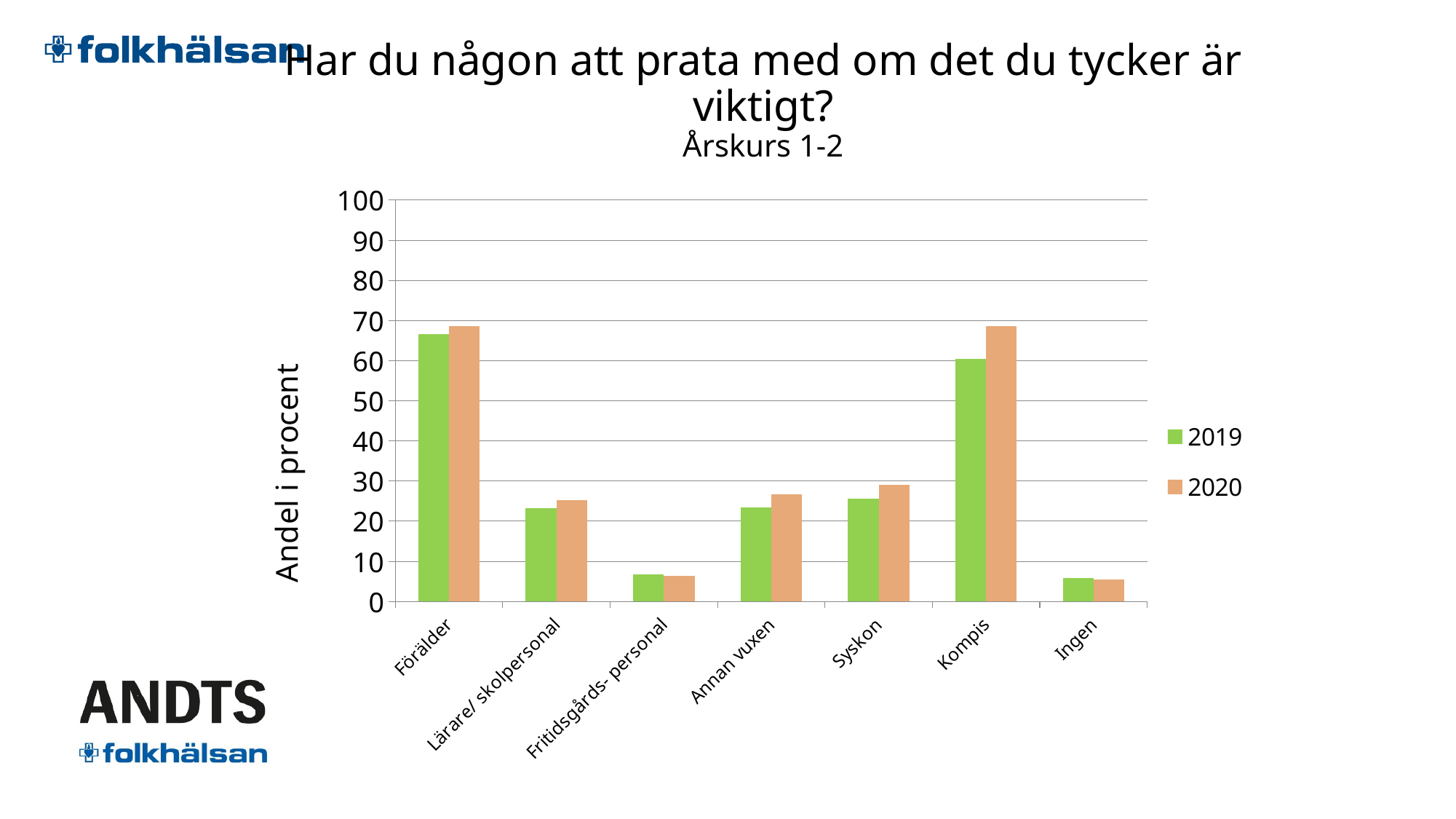
How many series does the legend list? 2 How many categories are shown on the x axis? 7 Is the value for Ingen in 2020 greater or less than 10? less Which series is shown in green? 2019 Which category has the highest value for 2019? Förälder Is the value for Förälder in 2019 greater or less than 60? greater What is the label of the vertical axis? Andel i procent Is the value for Kompis in 2020 greater or less than 60? greater For Kompis, which year has the larger value, 2019 or 2020? 2020 What kind of chart is shown on the slide? bar chart